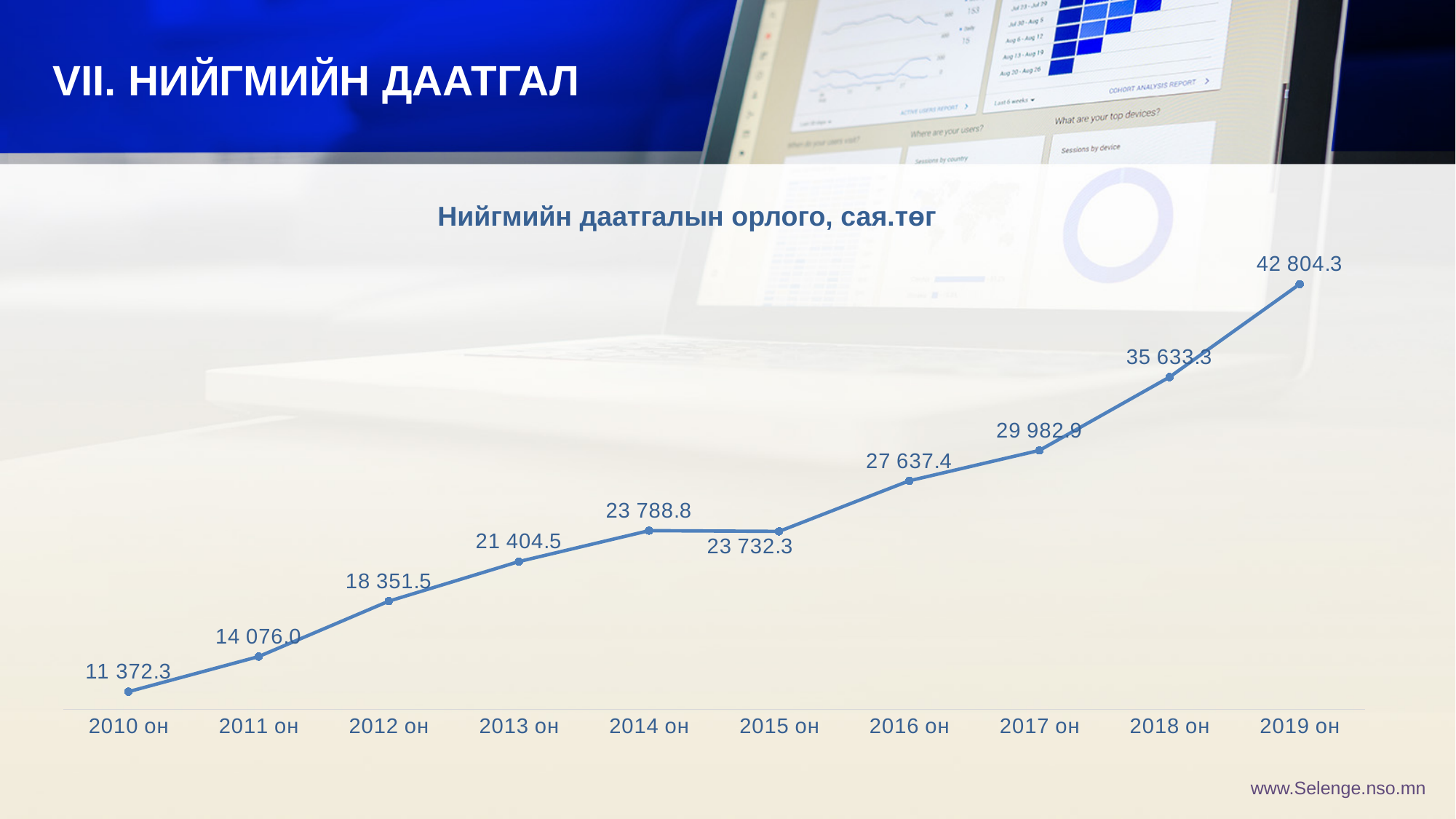
What type of chart is shown on the slide? line chart Do the values generally rise or fall from 2010 он to 2019 он? rise How many years are plotted on the chart? 10 What is the value for 2010 он? 11 372.3 Which year has the lowest value? 2010 он What is the difference between the values for 2014 он and 2015 он? 56.5 What is the value for 2018 он? 35 633.3 What is the difference between the values for 2019 он and 2018 он? 7 171.0 What is the title of the chart? Нийгмийн даатгалын орлого, сая.төг Which year has the highest value? 2019 он What is the value for 2015 он? 23 732.3 Which is larger, the value for 2014 он or the value for 2015 он? 2014 он